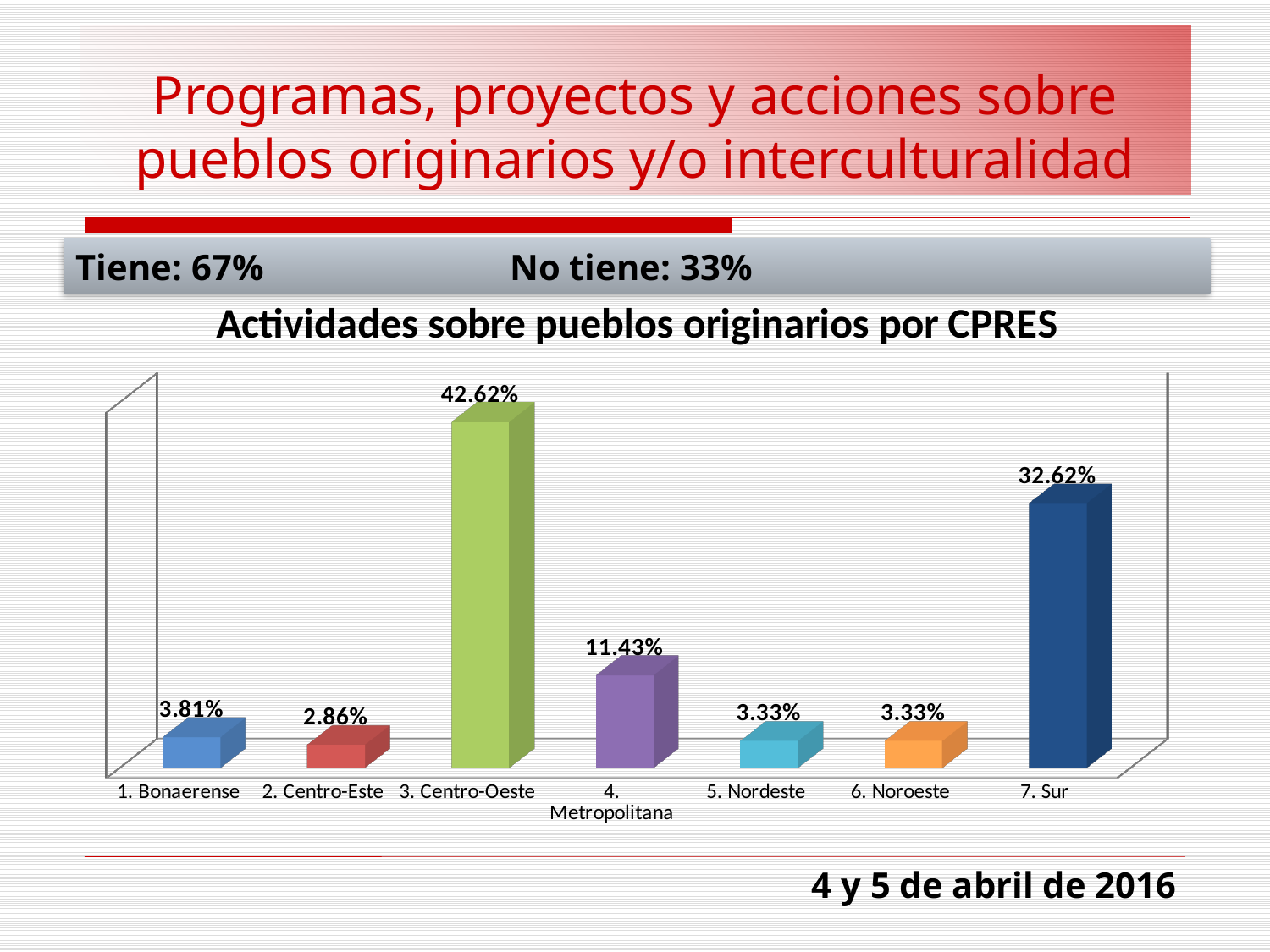
What is the value for 4. Metropolitana? 11.43% What is the value for 1. Bonaerense? 3.81% Which category has the highest value? 3. Centro-Oeste Which category has the lowest value? 2. Centro-Este How many categories are shown in the chart? 7 What is the difference between the values for 4. Metropolitana and 1. Bonaerense? 7.62% Which is larger, the value for 1. Bonaerense or the value for 2. Centro-Este? 1. Bonaerense What is the value for 3. Centro-Oeste? 42.62% What is the title of the chart? Actividades sobre pueblos originarios por CPRES What kind of chart is shown on the slide? Bar chart What is the difference between the values for 3. Centro-Oeste and 7. Sur? 10.00% What is the value for 7. Sur? 32.62%